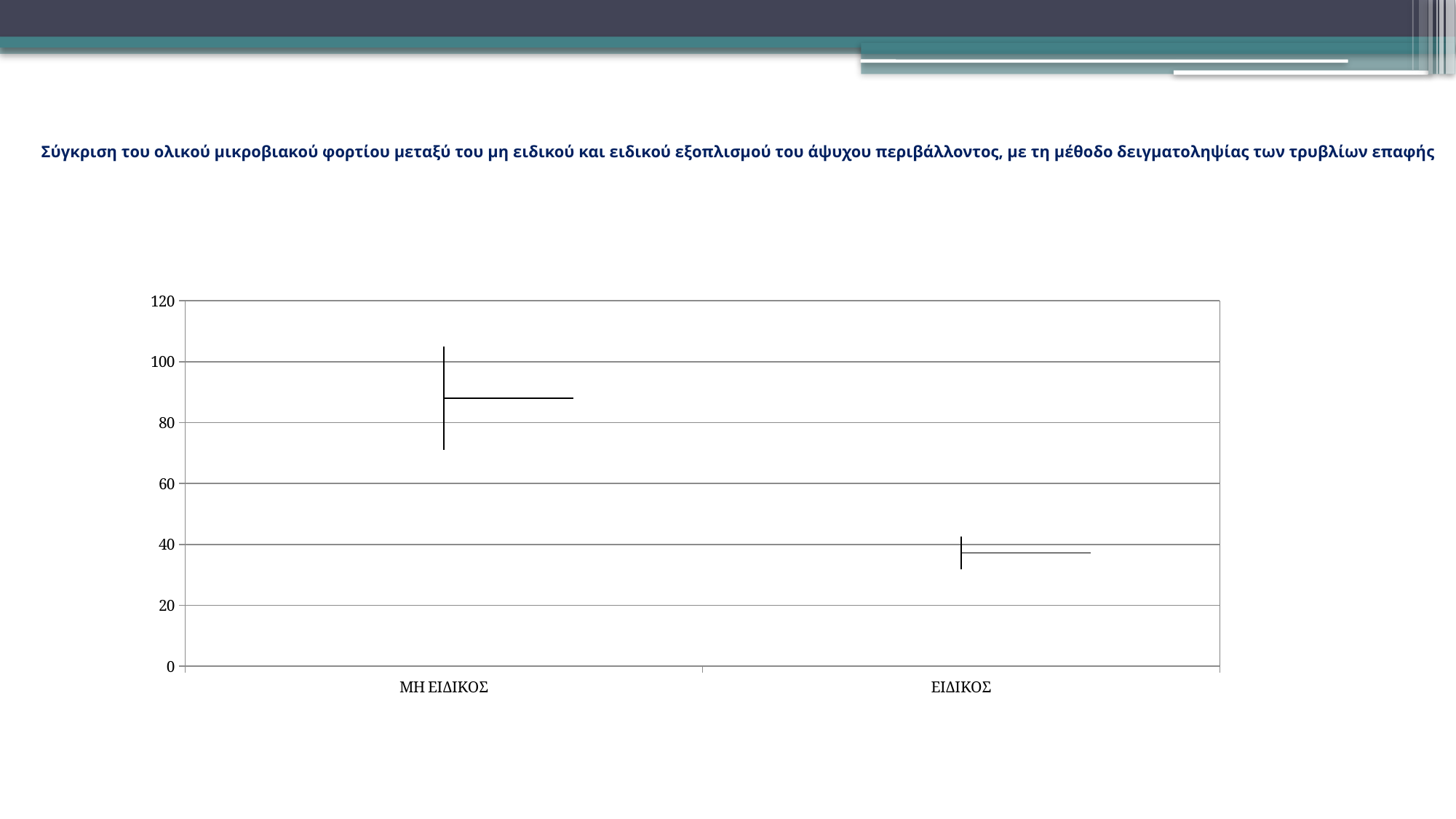
Is the value for ΕΙΔΙΚΟΣ greater or less than 60? less What is the maximum value shown on the vertical axis of the chart? 120 Which category has the higher value, ΜΗ ΕΙΔΙΚΟΣ or ΕΙΔΙΚΟΣ? ΜΗ ΕΙΔΙΚΟΣ Do the values rise or fall moving from ΜΗ ΕΙΔΙΚΟΣ to ΕΙΔΙΚΟΣ along the x axis? fall Which category shows the highest value in the chart? ΜΗ ΕΙΔΙΚΟΣ Which category shows the lowest value in the chart? ΕΙΔΙΚΟΣ How many categories are shown on the x axis of the chart? 2 What is the label of the rightmost category on the x axis? ΕΙΔΙΚΟΣ Is the value for ΕΙΔΙΚΟΣ greater or less than 20? greater